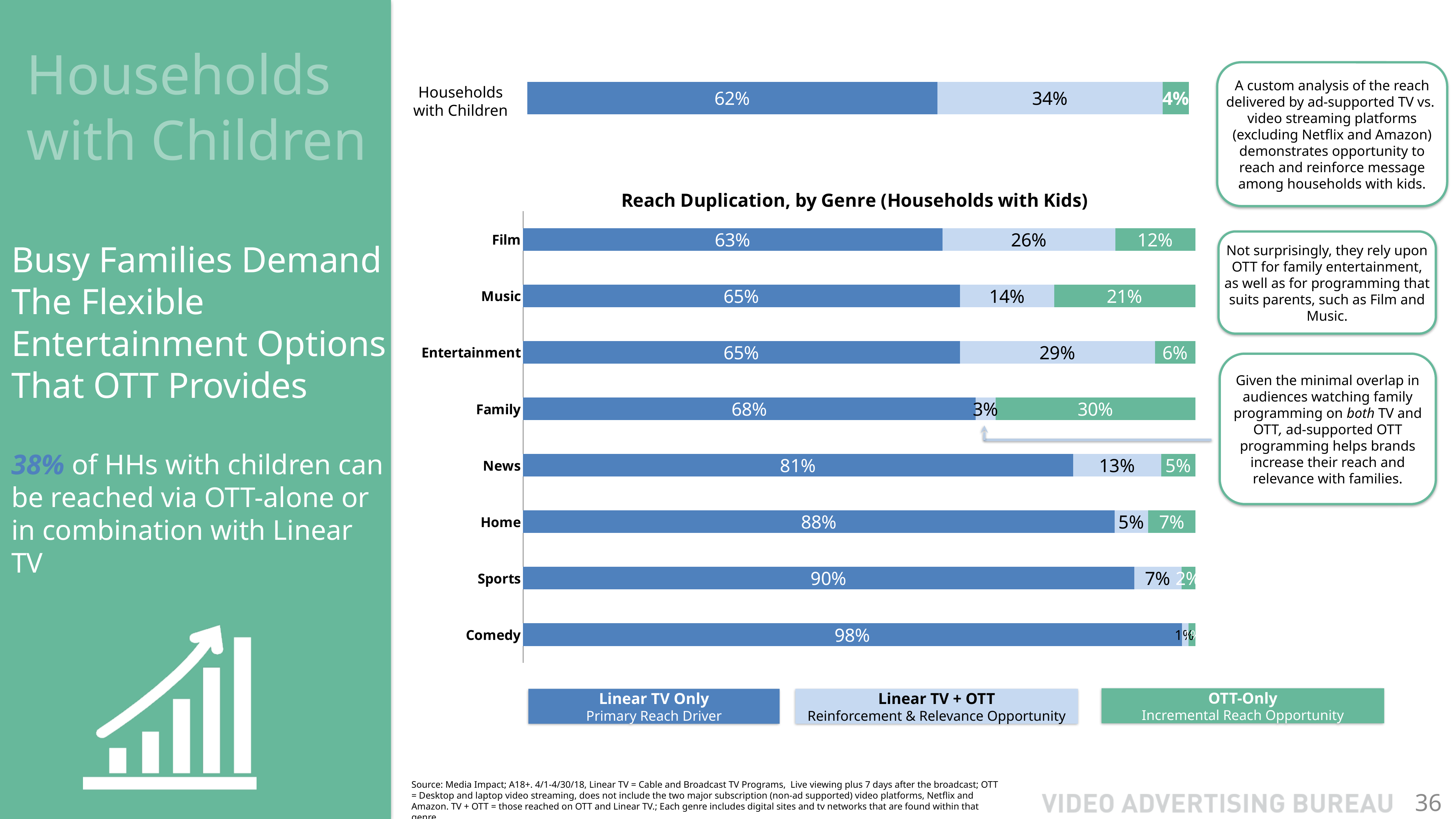
In the top Households with Children bar, what is the Linear TV + OTT value? 34% In the Reach Duplication, by Genre chart, what is the difference between the OTT-Only values for Music and Entertainment? 15 percentage points In the Reach Duplication, by Genre chart, which genre has the lowest Linear TV Only value? Film In the Reach Duplication, by Genre chart, what is the OTT-Only value for Family? 30% What kind of chart is the Reach Duplication, by Genre chart? Stacked bar chart How many genres are shown in the Reach Duplication, by Genre chart? 8 In the Reach Duplication, by Genre chart, which genre has the highest Linear TV Only value? Comedy In the Reach Duplication, by Genre chart, which has the larger Linear TV + OTT value, News or Home? News In the Reach Duplication, by Genre chart, which genre has the highest OTT-Only value? Family How many series does the legend of the Reach Duplication, by Genre chart list? 3 In the Reach Duplication, by Genre chart, what is the Linear TV Only value for Film? 63% In the Reach Duplication, by Genre chart, what is the Linear TV + OTT value for Entertainment? 29%